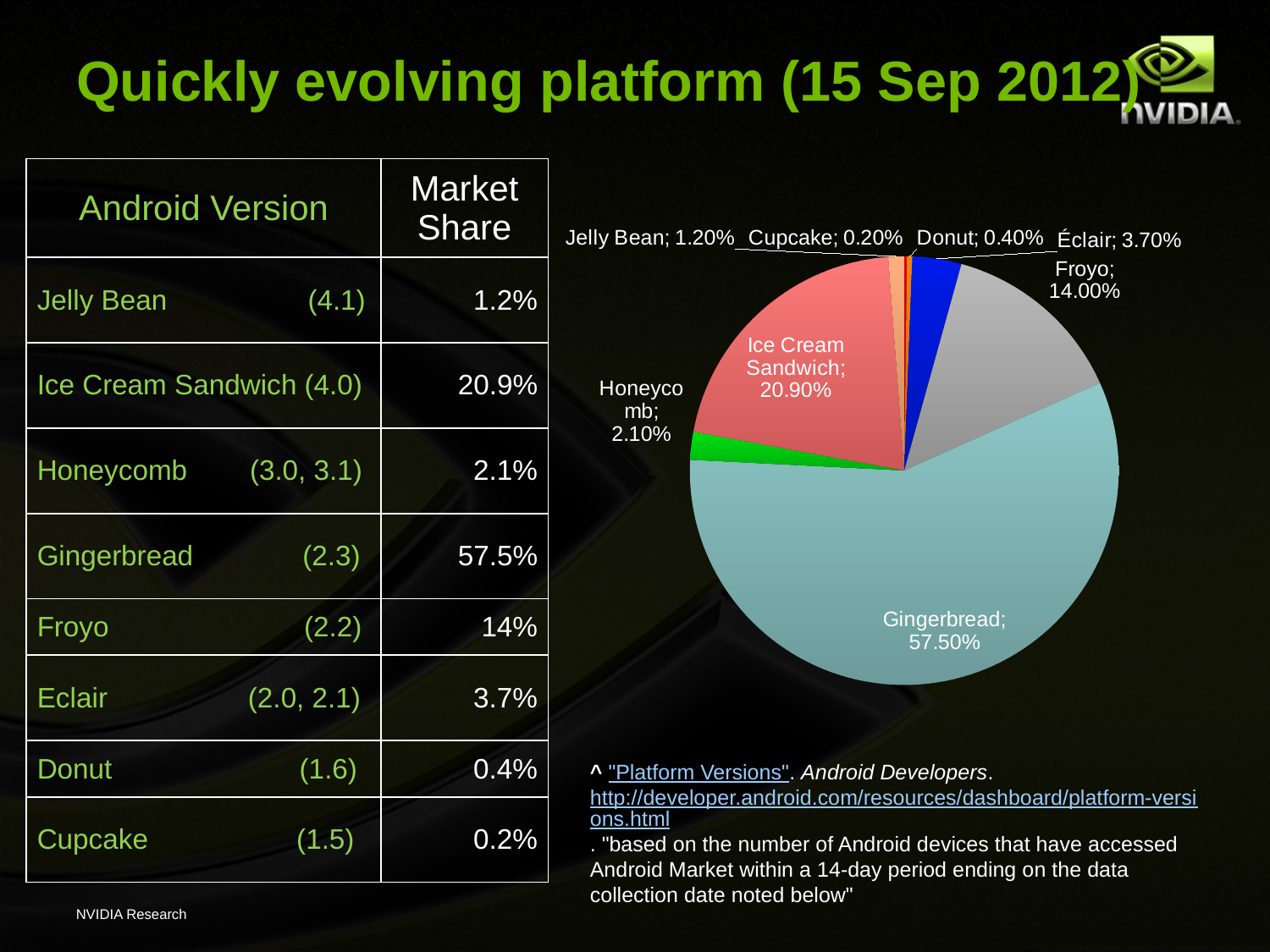
What kind of chart is shown on the slide? pie chart In the pie chart, what is the value shown for Froyo? 14.00% In the pie chart, what is the value shown for Ice Cream Sandwich? 20.90% How many slices does the pie chart have? 8 Which slice of the pie chart is the largest? Gingerbread In the pie chart, what is the difference between the Froyo and Éclair values? 10.30% In the pie chart, what is the value shown for Éclair? 3.70% In the pie chart, what is the difference between the Gingerbread and Ice Cream Sandwich values? 36.60% In the pie chart, what is the value shown for Honeycomb? 2.10% Which slice of the pie chart is the smallest? Cupcake In the pie chart, what is the value shown for Gingerbread? 57.50% In the pie chart, which is larger, Jelly Bean or Donut? Jelly Bean